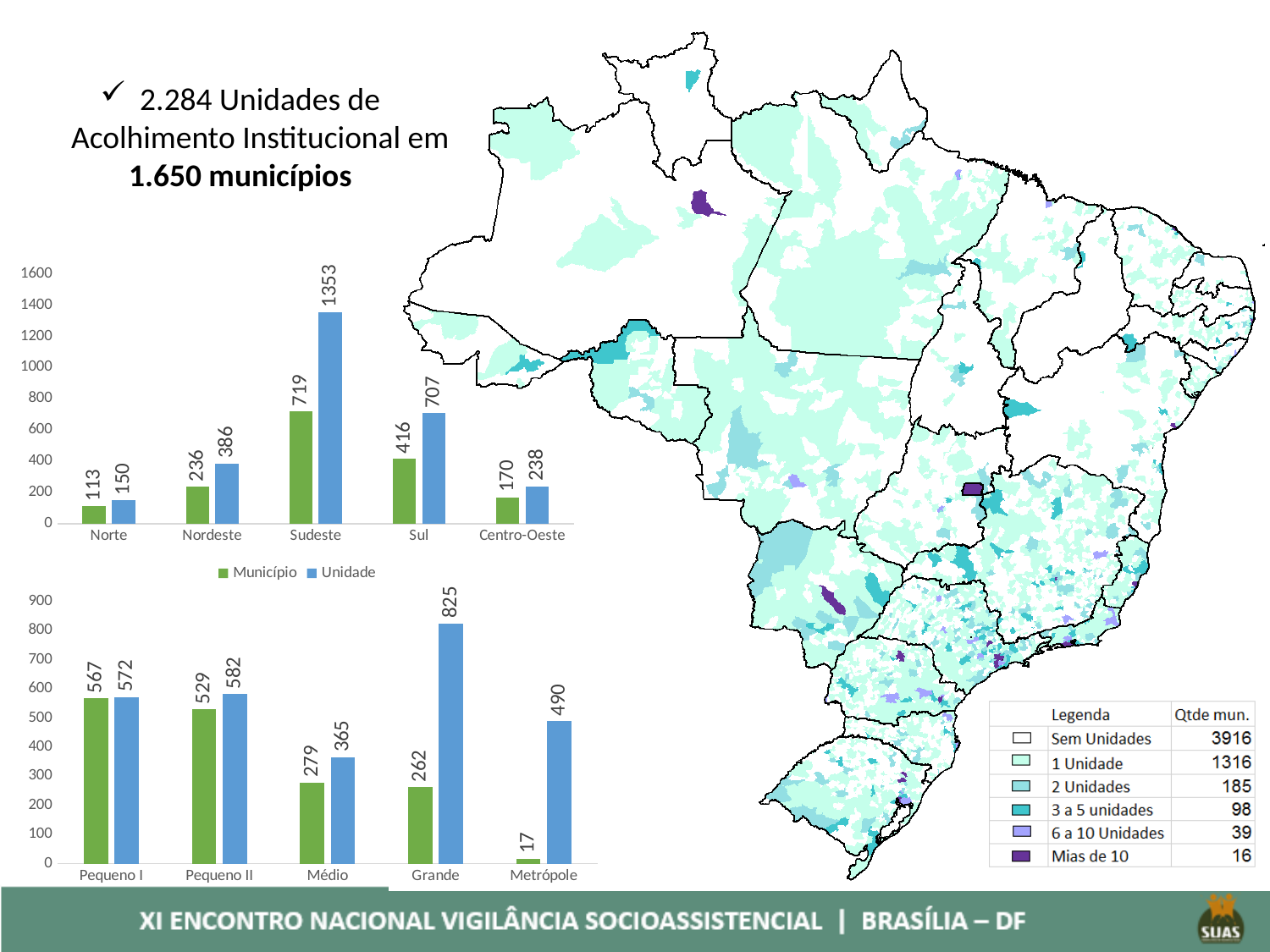
In the top chart (by region), how many regions are shown on the x axis? 5 In the bottom chart (by municipality size), what is the difference between the Unidade values for Grande and Metrópole? 335 What kind of chart is the top chart (by region)? bar chart In the top chart (by region), what is the difference between the Unidade and Município values for Sul? 291 In the bottom chart (by municipality size), which category has the highest Unidade value? Grande In the bottom chart (by municipality size), what is the Município value for Metrópole? 17 In the top chart (by region), what is the Unidade value for Sudeste? 1353 How many series does the legend list for the bar charts? 2 In the bottom chart (by municipality size), what is the Unidade value for Grande? 825 In the bottom chart (by municipality size), which is larger, the Município value for Pequeno I or for Médio? Pequeno I In the top chart (by region), what is the Município value for Nordeste? 236 In the top chart (by region), which region has the lowest Município value? Norte